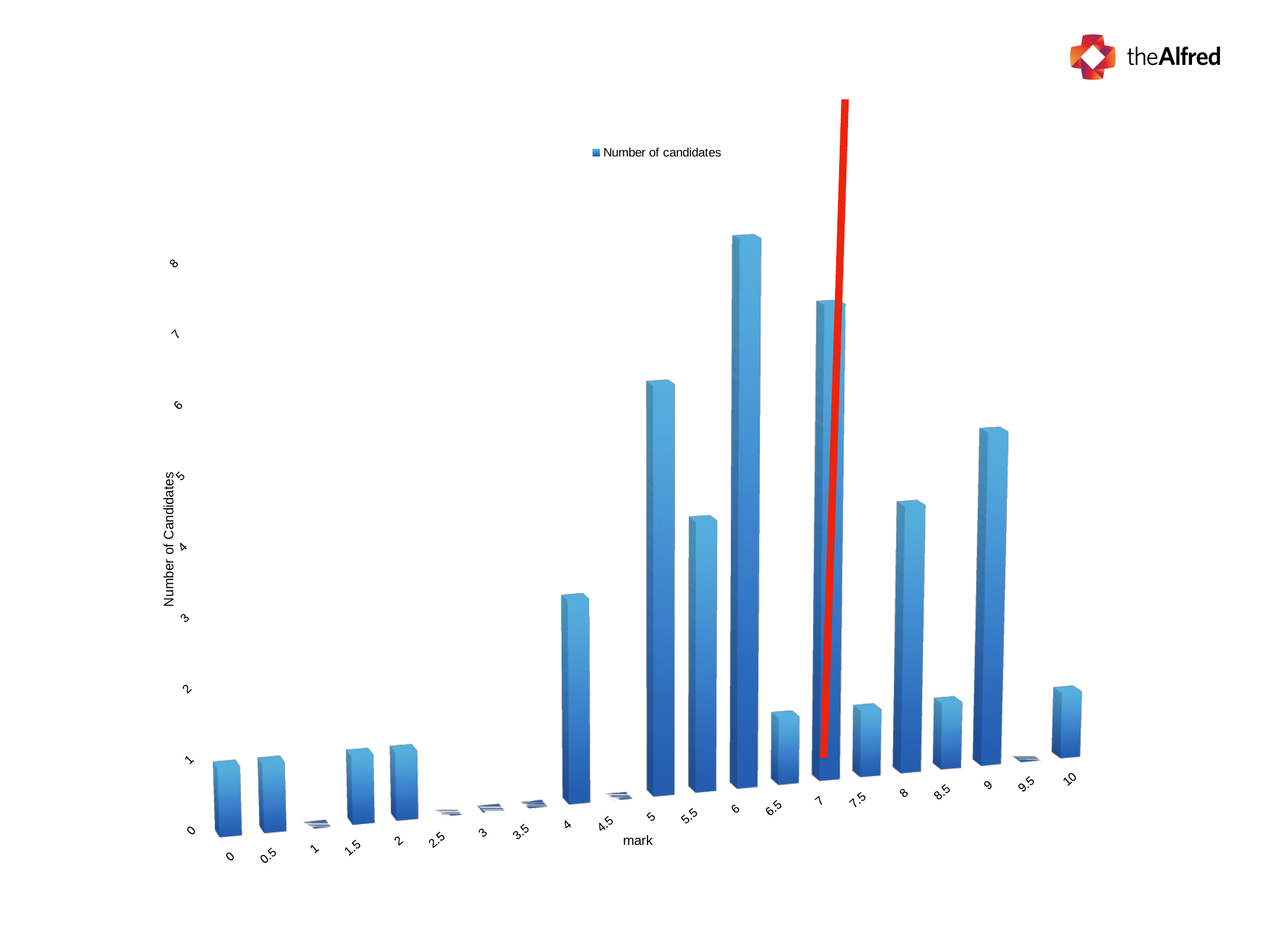
Which is larger, the number of candidates at mark 5 or at mark 4? mark 5 Which mark has the highest number of candidates? 6 How many series does the legend list? 1 What is the series name shown in the legend? Number of candidates Which is larger, the number of candidates at mark 6 or at mark 7? mark 6 Which is larger, the number of candidates at mark 9 or at mark 8? mark 9 How many mark categories are shown along the x axis? 21 What is the title of the x axis? mark Is the number of candidates at mark 0 greater or less than 2? less What kind of chart is shown on the slide? bar chart Is the number of candidates at mark 6 greater or less than 4? greater Is the number of candidates at mark 9 greater or less than 3? greater